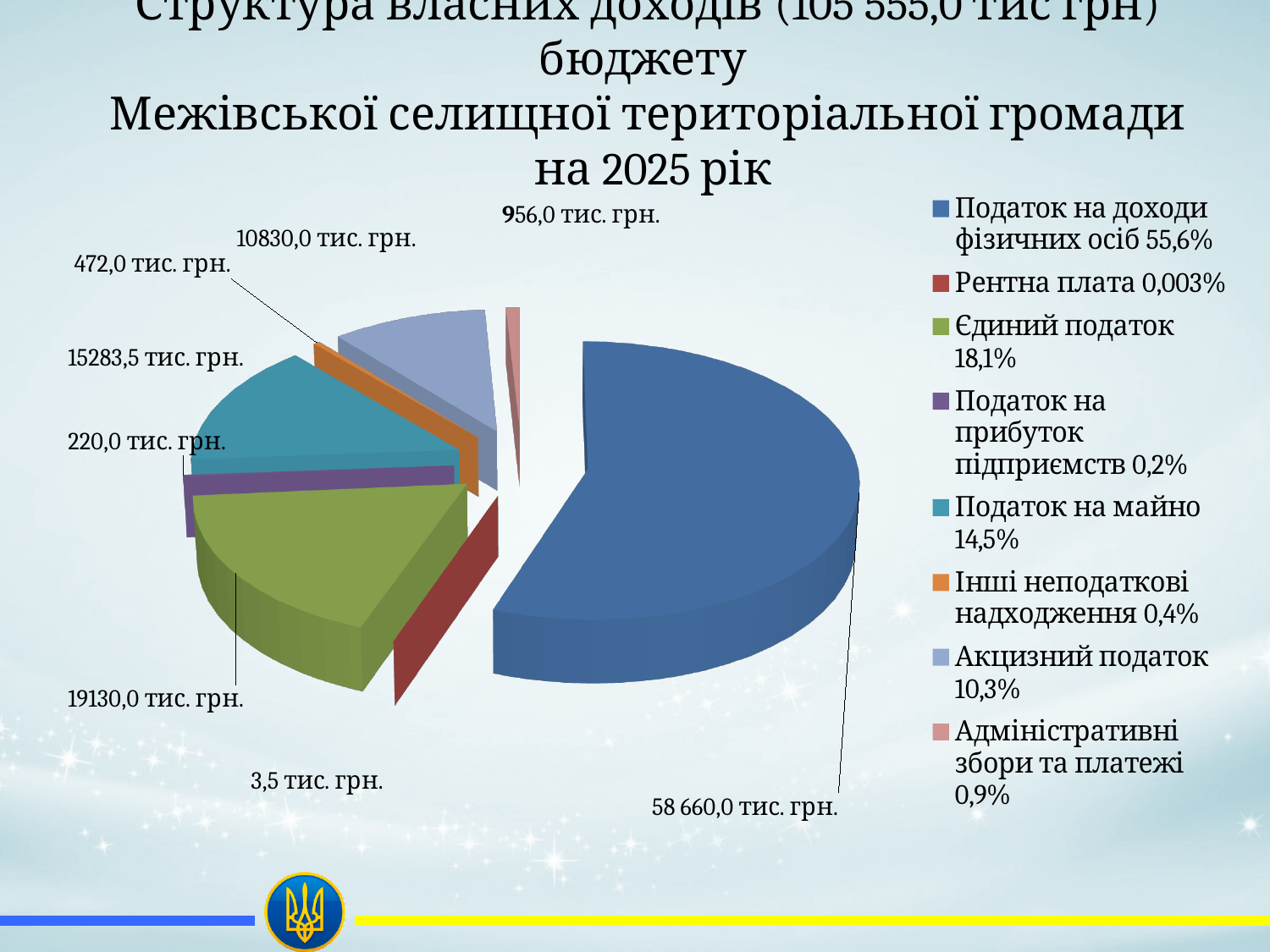
How many slices (categories) does the pie chart have? 8 Which is larger: the value for Акцизний податок or the value for Податок на майно? Податок на майно What is the value for Податок на майно? 15283,5 тис. грн. What is the value for Податок на доходи фізичних осіб? 58 660,0 тис. грн. What share of the pie does Єдиний податок represent? 18,1% What is the difference between the values for Єдиний податок and Податок на майно? 3846,5 тис. грн. What kind of chart is shown on the slide? Pie chart Which category has the smallest slice of the pie? Рентна плата What is the value for Акцизний податок? 10830,0 тис. грн. Which category has the largest slice of the pie? Податок на доходи фізичних осіб What is the value for Єдиний податок? 19130,0 тис. грн. What share of the pie does Адміністративні збори та платежі represent? 0,9%